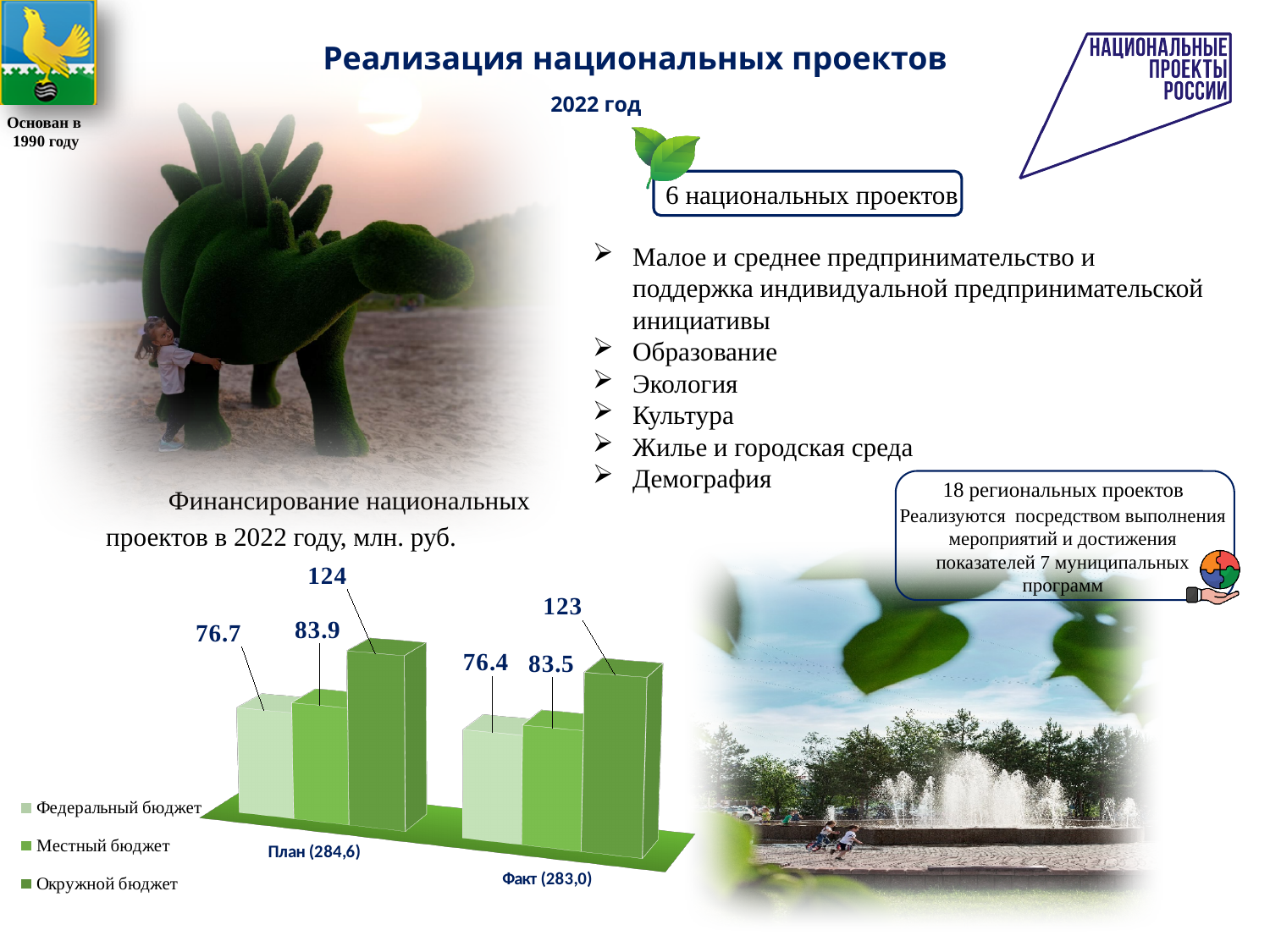
What is the difference between the Окружной бюджет values for План (284,6) and Факт (283,0)? 1 What is the value for Окружной бюджет in the Факт (283,0) category? 123 Which series has the lowest value in the Факт (283,0) category? Федеральный бюджет Which is larger: Местный бюджет for План (284,6) or Местный бюджет for Факт (283,0)? План (284,6) What is the value for Окружной бюджет in the План (284,6) category? 124 Which series has the highest value in the План (284,6) category? Окружной бюджет How many categories are shown on the x axis of the chart? 2 How many series does the chart legend list? 3 What is the value for Федеральный бюджет in the План (284,6) category? 76.7 What type of chart is used to show the financing of national projects? Bar chart What is the value for Местный бюджет in the Факт (283,0) category? 83.5 What is the title of the chart? Финансирование национальных проектов в 2022 году, млн. руб.